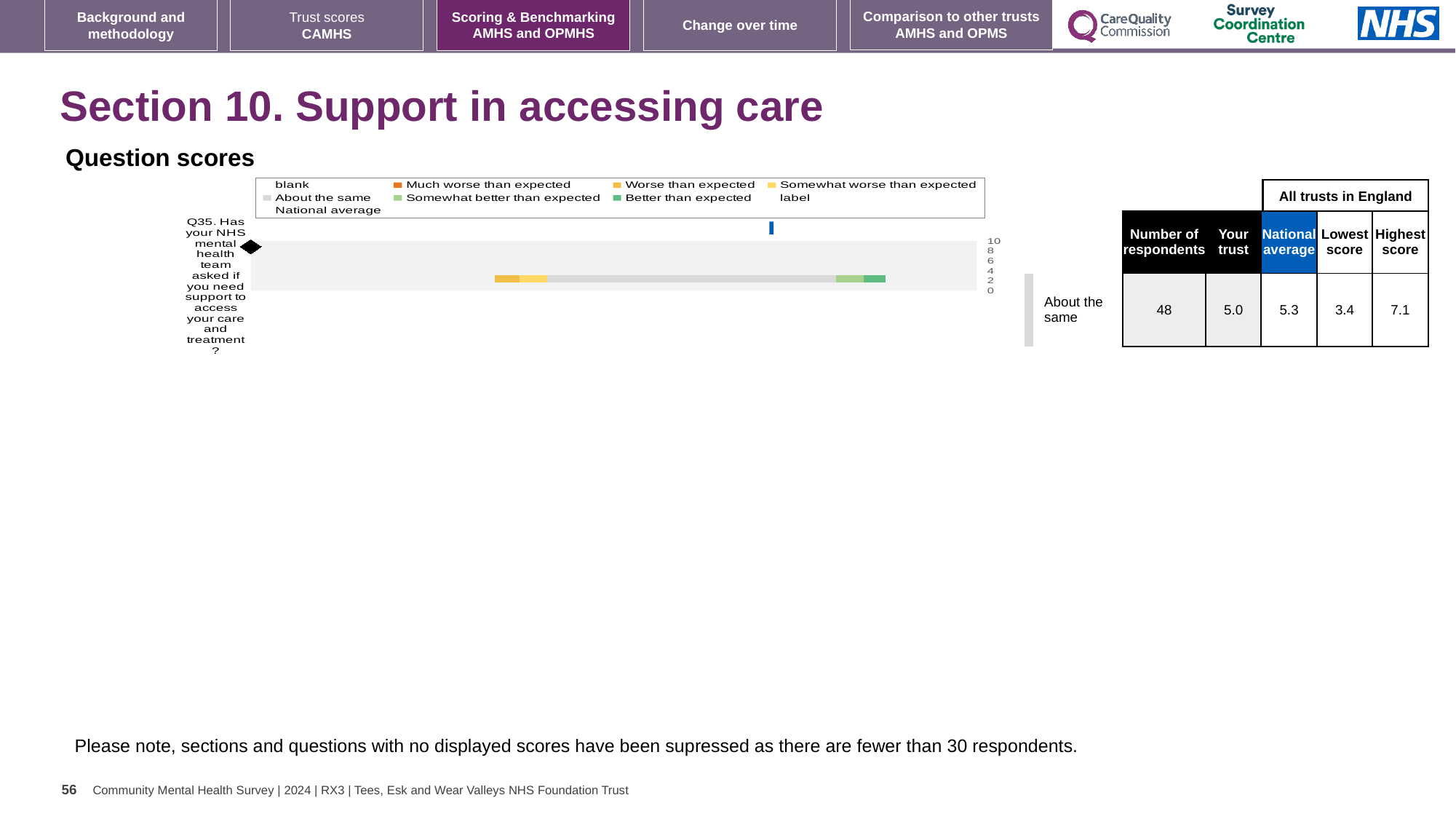
What is the highest value shown on the score axis of the Question scores chart? 10 What is the highest score among all trusts in England for Q35? 7.1 What is the difference between the highest score and the lowest score for Q35 across all trusts in England? 3.7 What is the lowest score among all trusts in England for Q35? 3.4 What kind of chart is used to show the Q35 question score? bar chart How many questions (categories) are plotted in the Question scores chart? 1 How many respondents answered Q35? 48 What is the trust's score for Q35 in the Question scores chart? 5.0 Which is larger for Q35: the trust's score or the national average? national average Which benchmark category is the trust's Q35 score assigned to? About the same How many entries does the legend of the Question scores chart list? 9 What is the national average score for Q35? 5.3